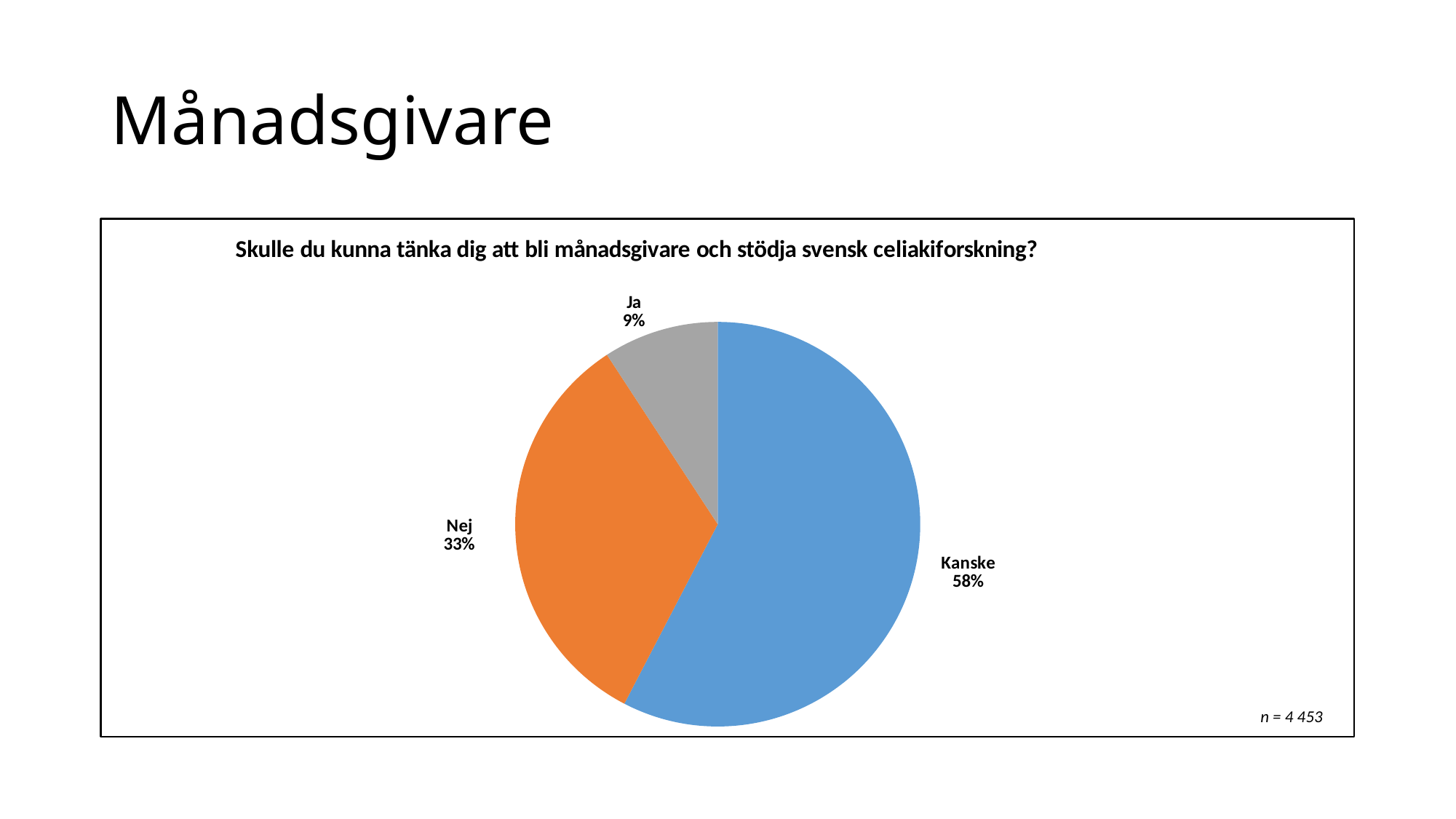
Which is larger, the share for "Nej" or the share for "Ja"? Nej What is the difference in percentage points between "Nej" and "Ja"? 24 What share of respondents answered "Kanske"? 58% Which answer has the smallest slice of the pie? Ja What share of respondents answered "Nej"? 33% Which answer has the largest slice of the pie? Kanske What is the title of the chart? Skulle du kunna tänka dig att bli månadsgivare och stödja svensk celiakiforskning? How many slices does the pie chart have? 3 What colour is the "Nej" slice? Orange What is the difference in percentage points between "Kanske" and "Nej"? 25 What type of chart is shown on the slide? Pie chart What share of respondents answered "Ja"? 9%